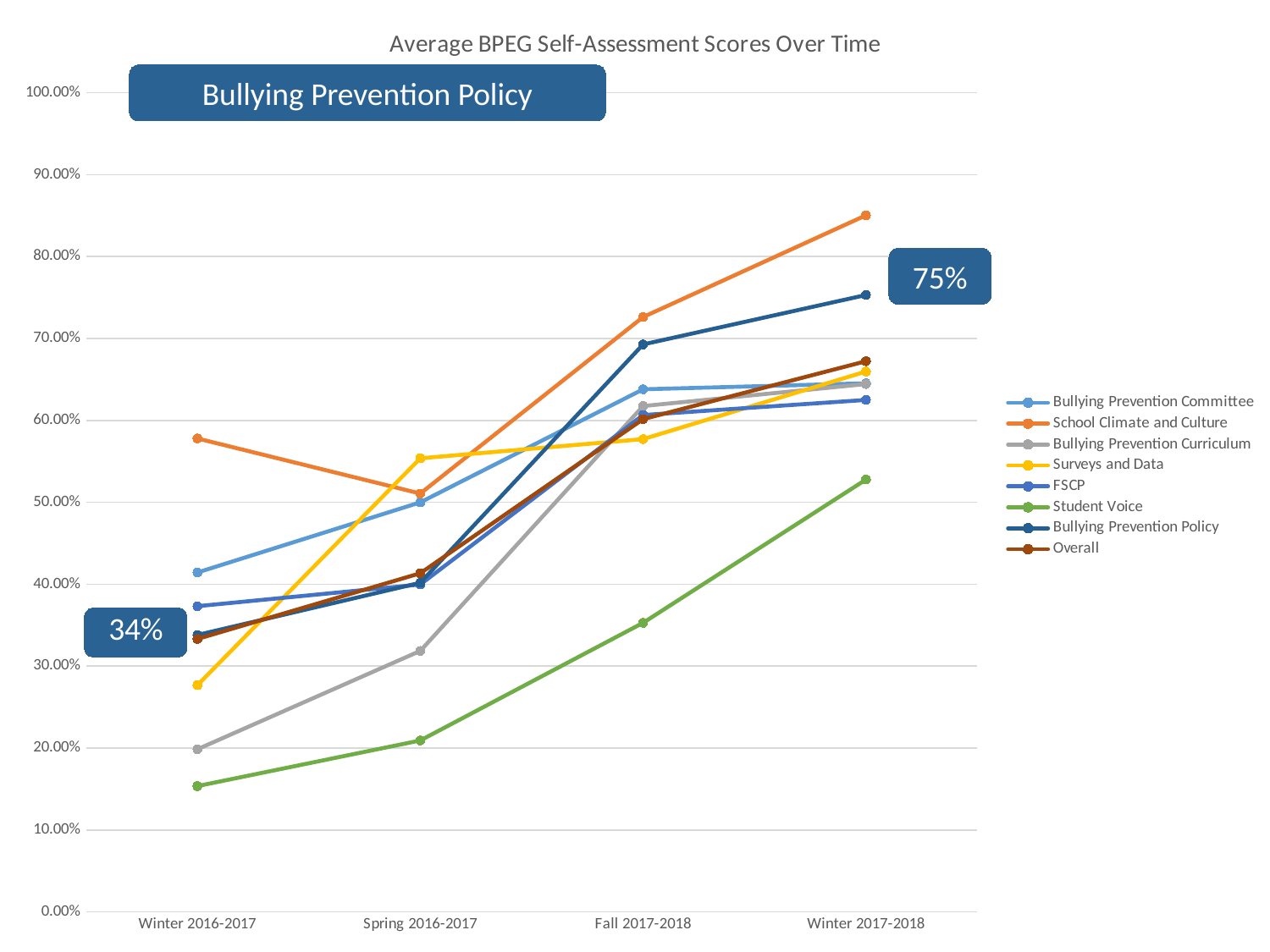
According to the callout on the slide, what was the Bullying Prevention Policy score at Winter 2017-2018? 75% Does the Student Voice series rise or fall from Winter 2016-2017 to Winter 2017-2018? Rise Which series has the lowest value at Winter 2016-2017? Student Voice How many time periods are shown on the x axis? 4 What is the title of the chart? Average BPEG Self-Assessment Scores Over Time Is the value for Student Voice at Fall 2017-2018 greater or less than 40.00%? less According to the callout on the slide, what was the Bullying Prevention Policy score at Winter 2016-2017? 34% Is the value for School Climate and Culture at Winter 2017-2018 greater or less than 80.00%? greater How many series does the legend list? 8 What type of chart is shown on the slide? Line chart At Winter 2016-2017, which is larger: School Climate and Culture or Bullying Prevention Committee? School Climate and Culture Which series has the highest value at Winter 2017-2018? School Climate and Culture